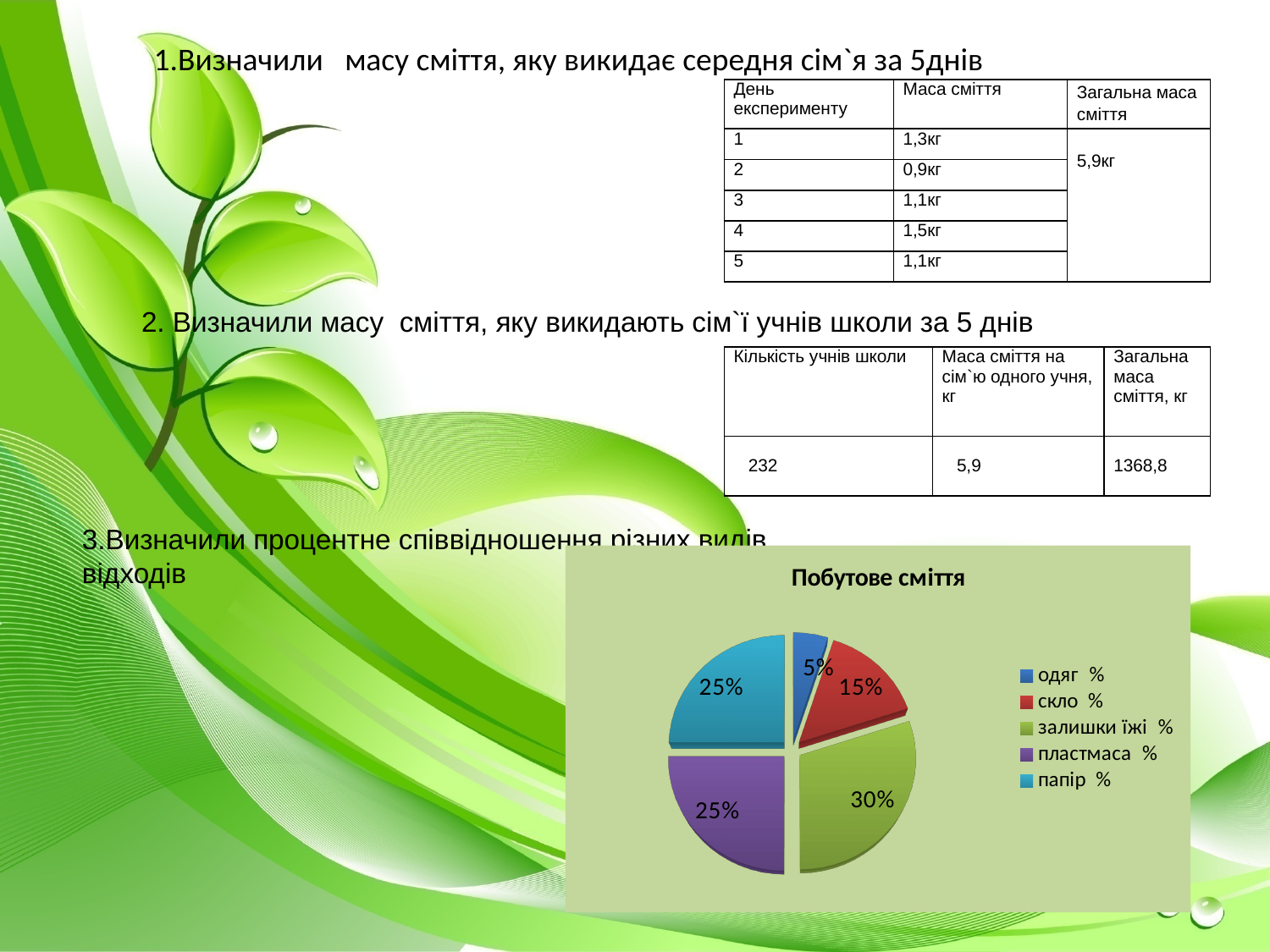
What percentage does the chart show for залишки їжі? 30% Which category has the smallest share of the pie? одяг What colour is the slice for папір? light blue How many entries does the chart legend list? 5 What type of chart is shown on the slide? pie chart What is the difference between the shares of залишки їжі and скло? 15% What percentage does the chart show for скло? 15% What percentage does the chart show for одяг? 5% Which is larger, the share of скло or the share of пластмаса? пластмаса Which category has the largest share of the pie? залишки їжі How many slices does the pie chart have? 5 What is the title of the chart? Побутове сміття